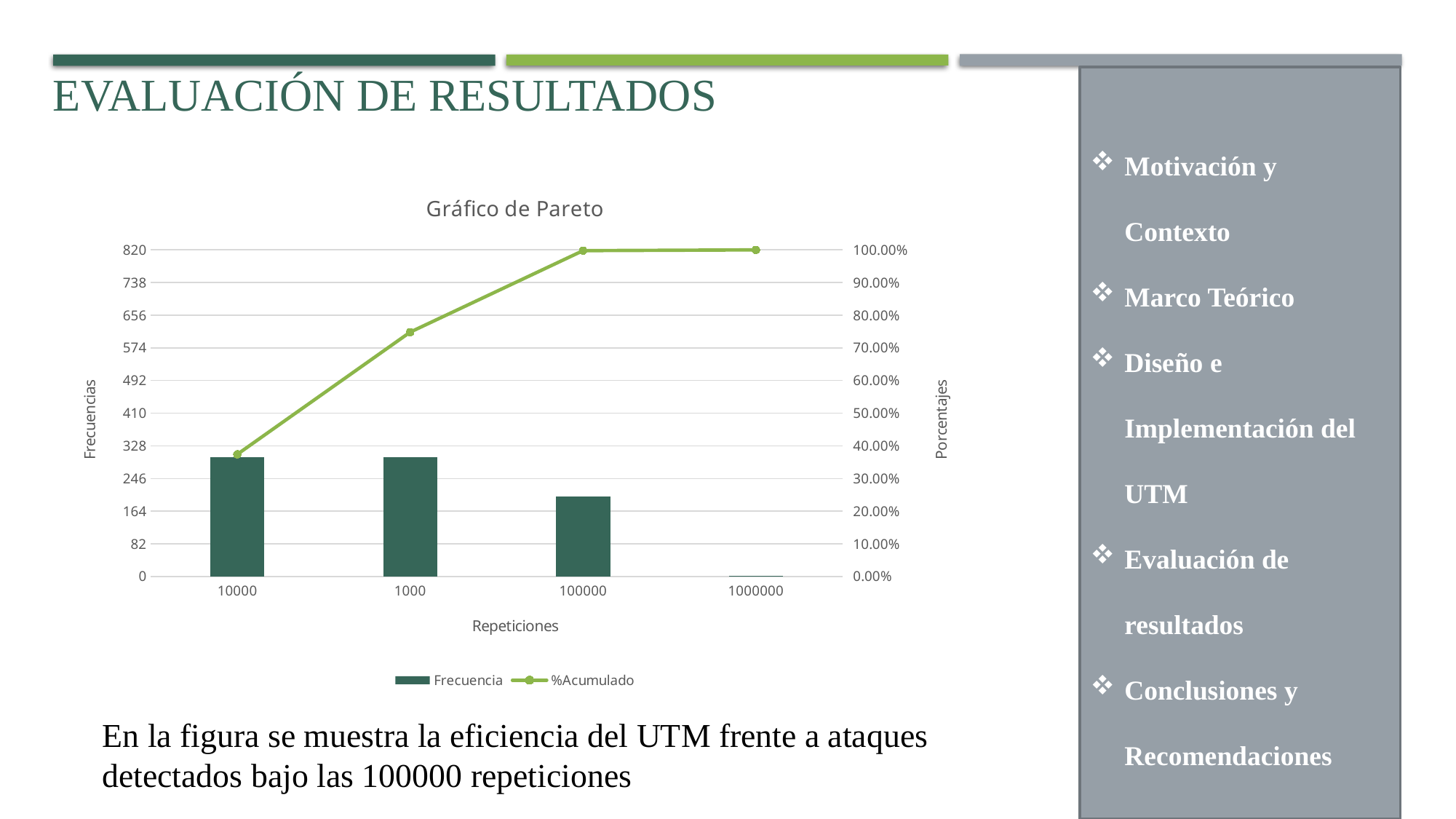
Which category has the lowest Frecuencia? 1000000 How many series does the legend list? 2 Does the %Acumulado line rise or fall from left to right along the x axis? It rises What type of chart is shown on the slide? A combined bar and line chart (Pareto chart) Is the %Acumulado value for 1000 repeticiones greater or less than 70.00%? greater How many categories are shown on the x axis? 4 Is the Frecuencia value for 100000 repeticiones greater or less than 246? less What is the title of the chart? Gráfico de Pareto Is the Frecuencia value for 10000 repeticiones greater or less than 246? greater What is the %Acumulado value for 1000000 repeticiones? 100.00% Which has a larger Frecuencia, 10000 or 100000 repeticiones? 10000